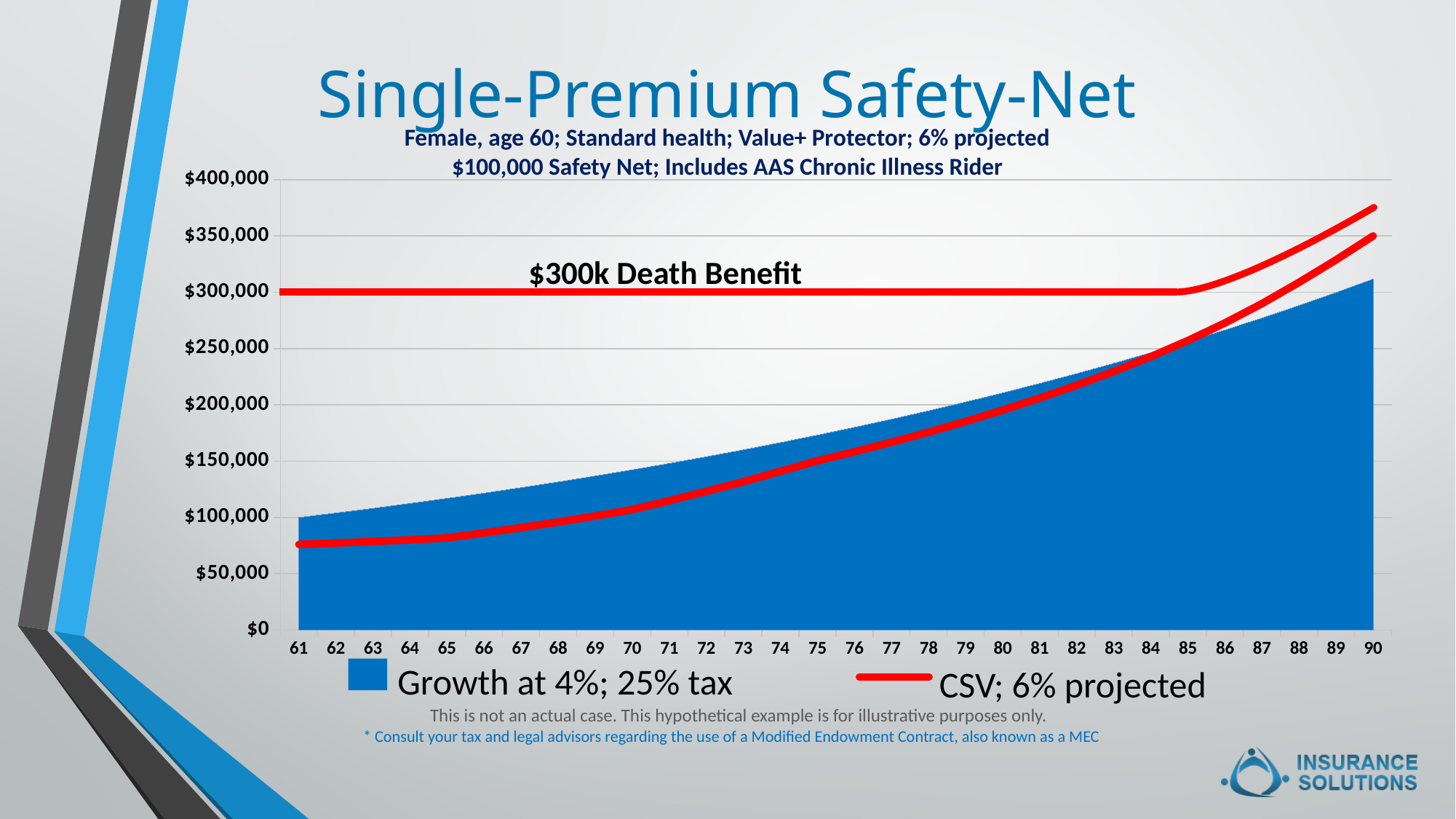
At age 70, which is larger: Growth at 4%; 25% tax or CSV; 6% projected? Growth at 4%; 25% tax Does the CSV; 6% projected line rise or fall as age increases from 61 to 90? rises What are the two legend entries of the chart? Growth at 4%; 25% tax and CSV; 6% projected Is the Growth at 4%; 25% tax value at age 70 greater or less than $100,000? greater At age 90, which is larger: Growth at 4%; 25% tax or CSV; 6% projected? CSV; 6% projected How many ages are shown along the x axis of the chart? 30 Is the CSV; 6% projected value at age 61 greater or less than $100,000? less What is the title of the slide containing the chart? Single-Premium Safety-Net What death benefit amount is labeled on the horizontal red line in the chart? $300k How many series does the chart's legend list? 2 Is the CSV; 6% projected value at age 90 greater or less than $300,000? greater What kind of chart is shown on the slide? combination area and line chart